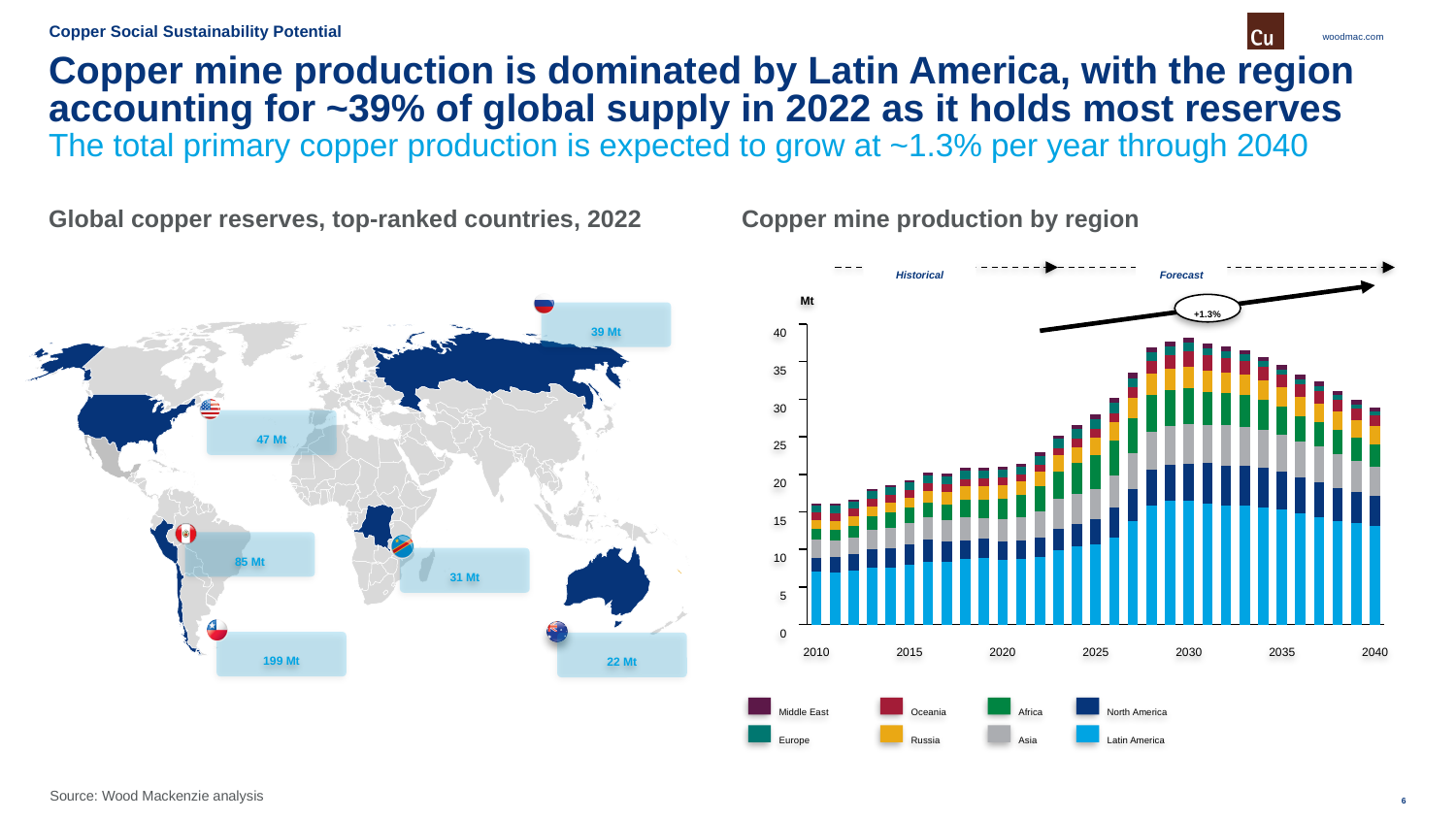
What growth rate is annotated on the 'Copper mine production by region' chart? +1.3% On the 'Global copper reserves, top-ranked countries, 2022' map, what is the smallest reserve value shown? 22 Mt In the 'Copper mine production by region' chart, does total production rise or fall between 2010 and 2030? rise In the 'Copper mine production by region' chart, is the total production for 2010 greater or less than 20 Mt? less How many series does the legend of the 'Copper mine production by region' chart list? 8 In the 'Copper mine production by region' chart, does total production rise or fall between 2030 and 2040? fall On the 'Global copper reserves, top-ranked countries, 2022' map, how many countries have a reserve value shown? 6 In the 'Copper mine production by region' chart, is the Latin America value for 2010 greater or less than 10 Mt? less In the 'Copper mine production by region' chart, is the total production for 2030 greater or less than 35 Mt? greater What type of chart is 'Copper mine production by region'? Stacked bar chart In the 'Copper mine production by region' chart, which region is shown in light blue at the bottom of each bar? Latin America On the 'Global copper reserves, top-ranked countries, 2022' map, what is the largest reserve value shown? 199 Mt